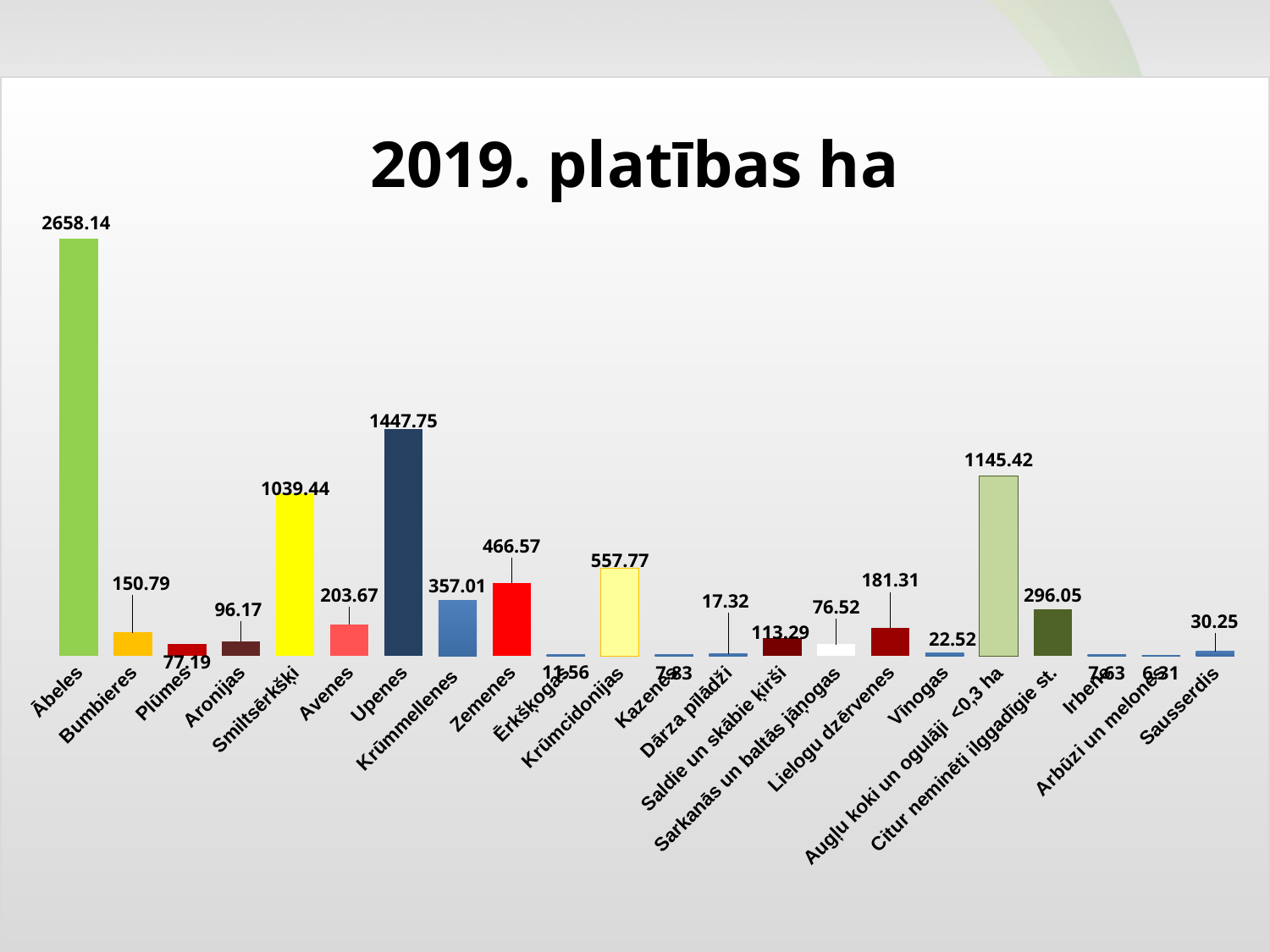
What is the title of the chart? 2019. platības ha What is the value for Augļu koki un ogulāji <0,3 ha? 1145.42 What is the value for Upenes? 1447.75 What is the difference between the values for Zemenes and Krūmmellenes? 109.56 How many categories are shown in the chart? 22 Which is larger, the value for Bumbieres or the value for Avenes? Avenes What is the value for Sausserdis? 30.25 What is the difference between the values for Upenes and Smiltsērkšķi? 408.31 Which is larger, the value for Lielogu dzērvenes or the value for Citur neminēti ilggadīgie st.? Citur neminēti ilggadīgie st. What is the value for Ābeles? 2658.14 Which category has the highest value? Ābeles What is the value for Krūmcidonijas? 557.77